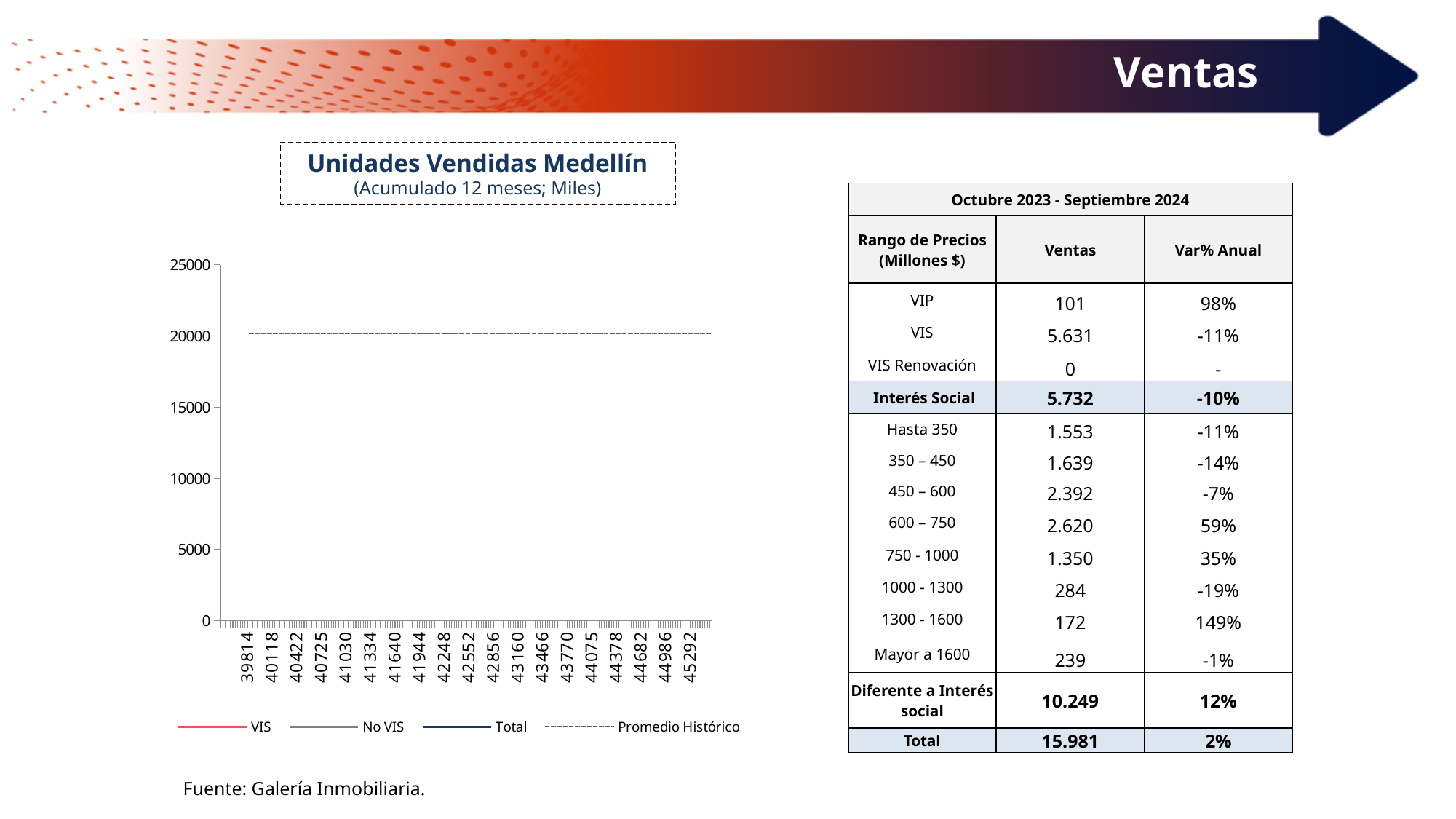
What kind of chart is shown under the title "Unidades Vendidas Medellín"? line chart What is the title of the chart on the left of the slide? Unidades Vendidas Medellín In the "Unidades Vendidas Medellín" chart, is the value of the Promedio Histórico line greater or less than 15000? greater In the "Unidades Vendidas Medellín" chart, is the value of the Promedio Histórico line greater or less than 25000? less Which series is drawn as a dashed line in the "Unidades Vendidas Medellín" chart? Promedio Histórico In the "Unidades Vendidas Medellín" chart, does the Promedio Histórico line rise, fall, or stay flat along the x axis? stay flat How many series does the legend of the "Unidades Vendidas Medellín" chart list? 4